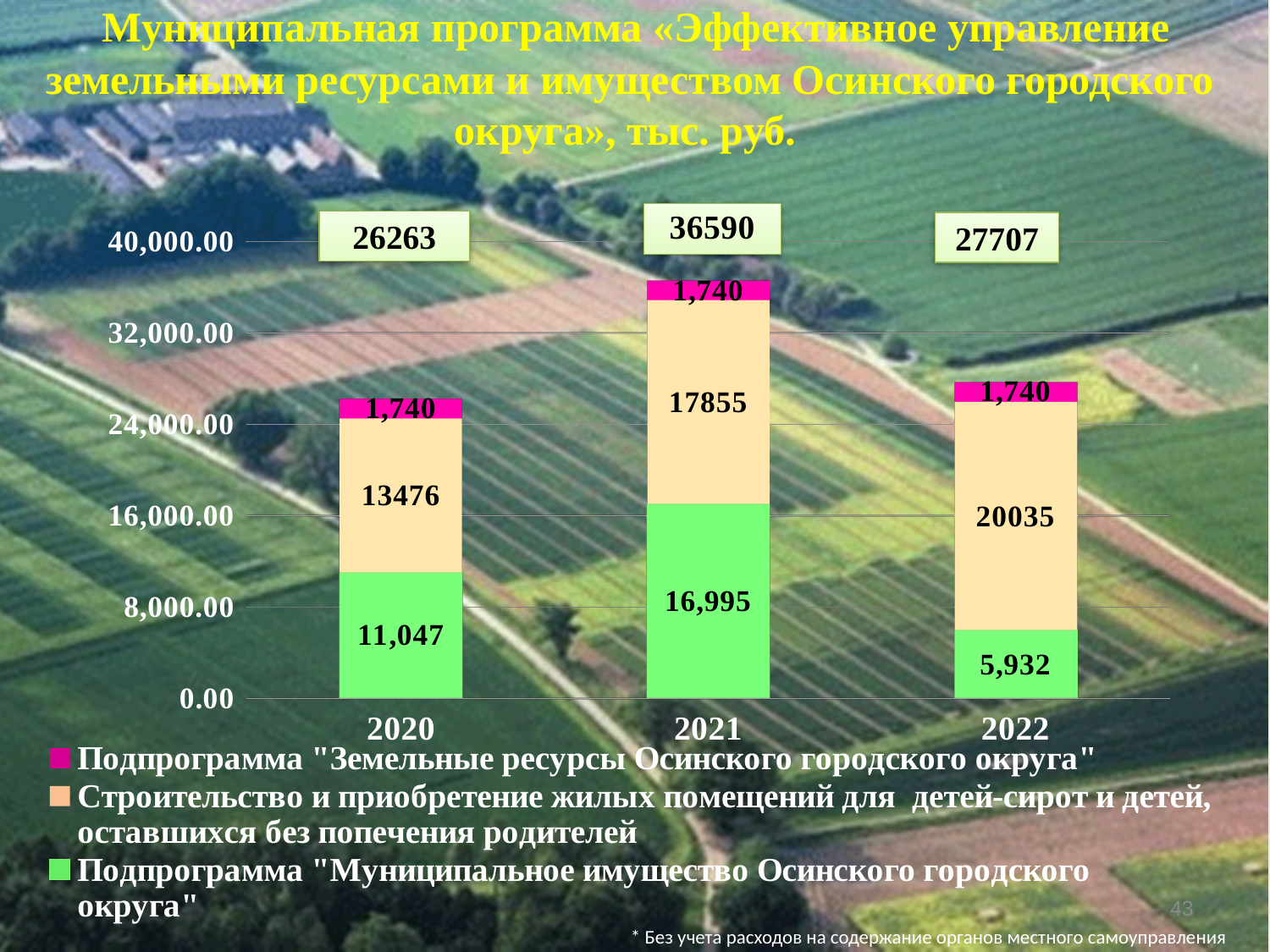
В каком году общая сумма по программе наибольшая? 2021 Какое значение показателя «Строительство и приобретение жилых помещений для детей-сирот и детей, оставшихся без попечения родителей» в 2022 году? 20035 Сколько рядов данных перечислено в легенде? 3 Какое значение подпрограммы «Муниципальное имущество Осинского городского округа» в 2020 году? 11,047 Какой тип диаграммы показан на слайде? Столбчатая диаграмма с накоплением Сколько лет (категорий) показано на оси x? 3 Какое значение подпрограммы «Земельные ресурсы Осинского городского округа» в 2021 году? 1,740 На сколько значение «Строительство и приобретение жилых помещений для детей-сирот» в 2021 году больше, чем в 2020 году? 4379 Что больше в 2022 году: подпрограмма «Муниципальное имущество Осинского городского округа» или «Строительство и приобретение жилых помещений для детей-сирот»? Строительство и приобретение жилых помещений для детей-сирот Каким цветом обозначена подпрограмма «Земельные ресурсы Осинского городского округа»? Розовым (малиновым) Какова общая сумма столбца за 2022 год? 27707 В каком году значение подпрограммы «Муниципальное имущество Осинского городского округа» наименьшее? 2022